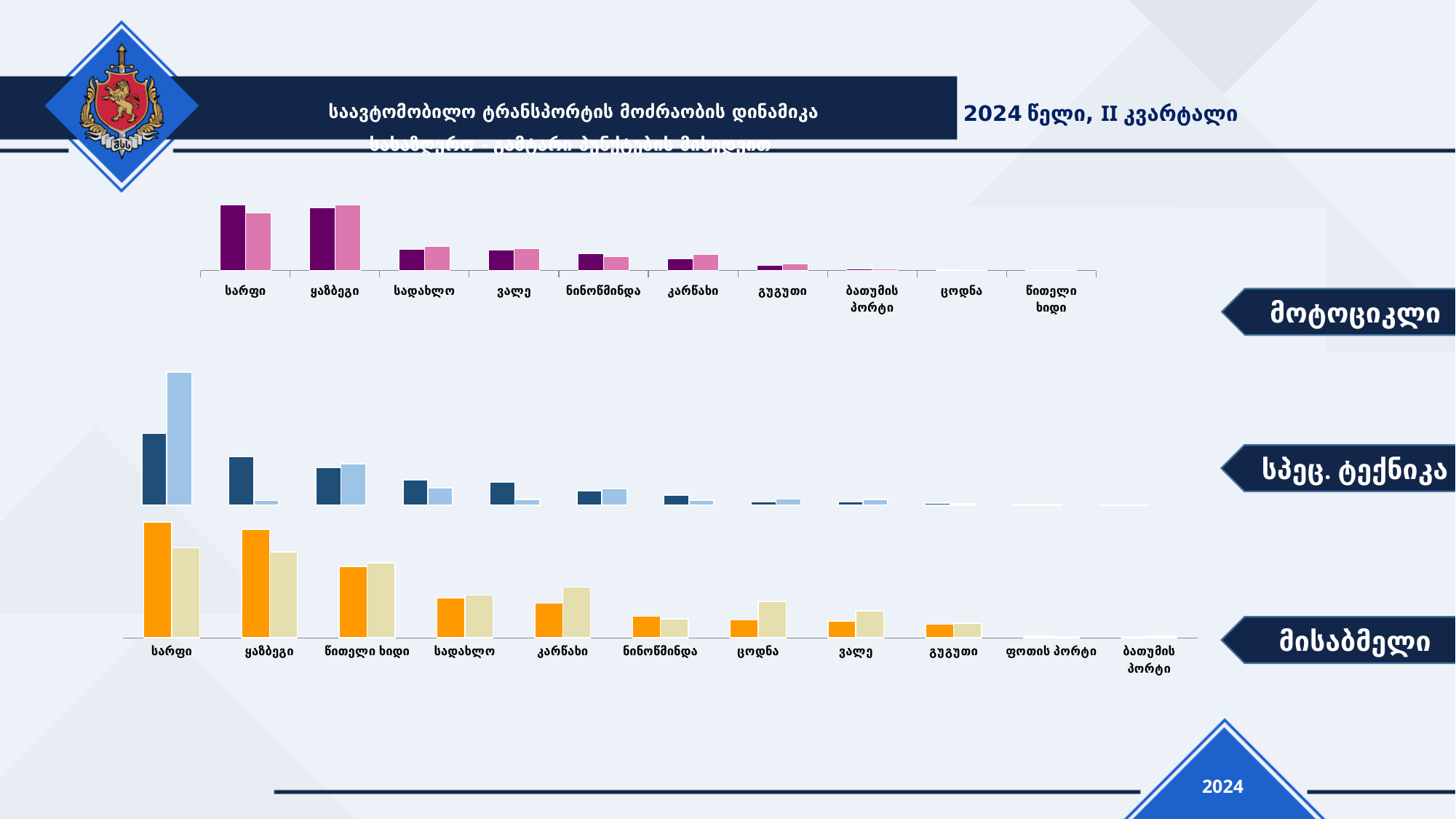
In the top chart (მოტოციკლი), which is larger, the dark bar for სადახლო or the dark bar for გუგუთი? სადახლო What kind of chart is the top chart labelled მოტოციკლი? bar chart How many categories are shown on the x axis of the bottom chart (მისაბმელი)? 11 What label is shown to the right of the middle chart? სპეც. ტექნიკა In the bottom chart (მისაბმელი), do the orange bars generally rise or fall from left to right along the x axis? fall How many categories are shown on the x axis of the top chart (მოტოციკლი)? 10 In the bottom chart (მისაბმელი), which is larger, the orange bar for წითელი ხიდი or the orange bar for გუგუთი? წითელი ხიდი What is the first category on the x axis of the bottom chart (მისაბმელი)? სარფი In the bottom chart (მისაბმელი), which is larger, the orange bar for სარფი or the orange bar for ცოდნა? სარფი In the top chart (მოტოციკლი), do the bar heights generally rise or fall from left to right along the x axis? fall